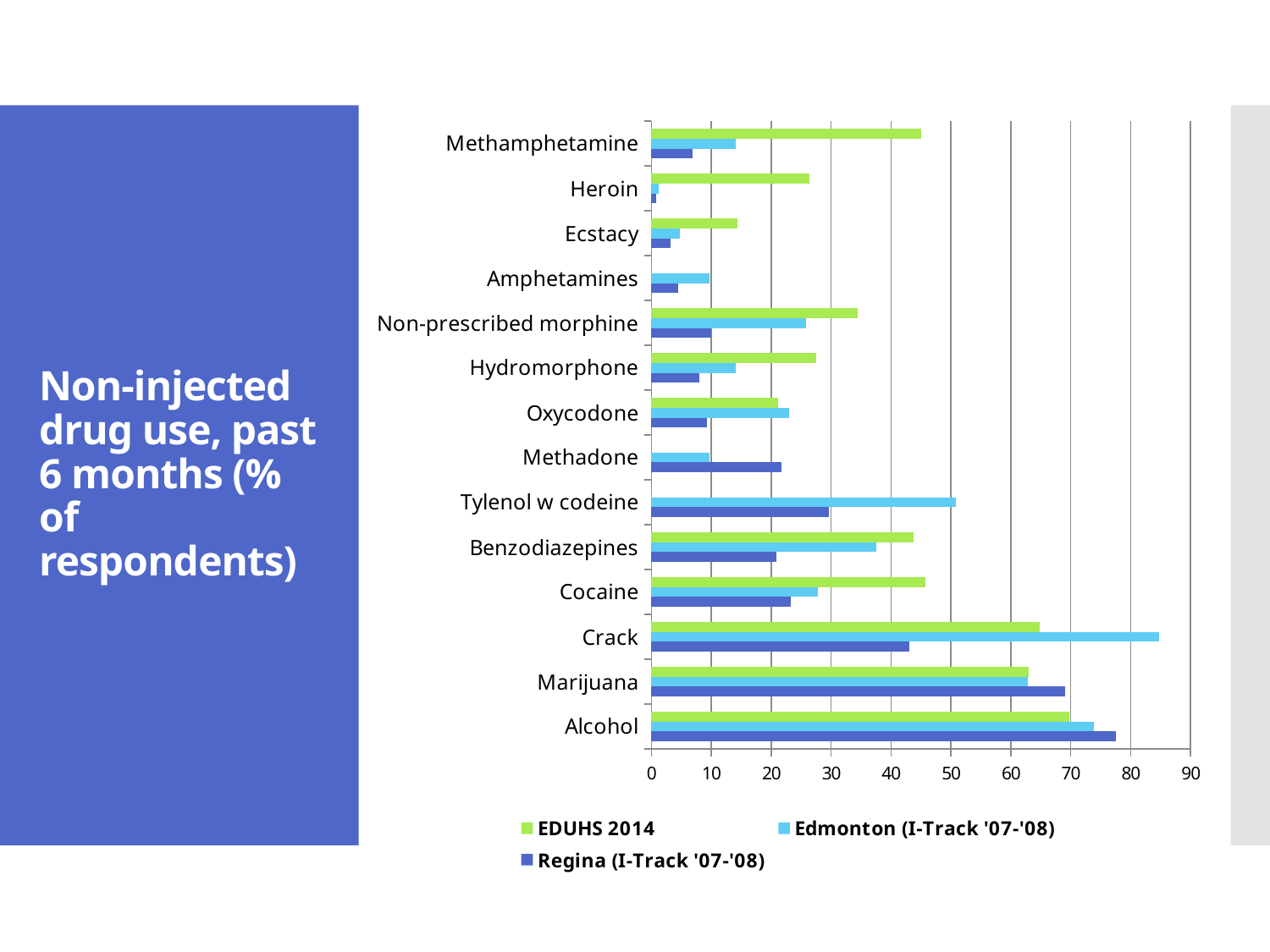
Is the Edmonton (I-Track '07-'08) value for Crack greater or less than 80? greater Which category has the highest value for the Regina (I-Track '07-'08) series? Alcohol How many drug categories are shown on the chart? 14 What kind of chart is shown on the slide? Bar chart Which category has the highest value for the Edmonton (I-Track '07-'08) series? Crack What is the title of the slide containing the chart? Non-injected drug use, past 6 months (% of respondents) Is the Regina (I-Track '07-'08) value for Alcohol greater or less than 70? greater Is the EDUHS 2014 value for Methamphetamine greater or less than 40? greater For Cocaine, which series has the larger value: EDUHS 2014 or Edmonton (I-Track '07-'08)? EDUHS 2014 How many series does the legend list? 3 For Crack, which series has the larger value: EDUHS 2014 or Edmonton (I-Track '07-'08)? Edmonton (I-Track '07-'08)